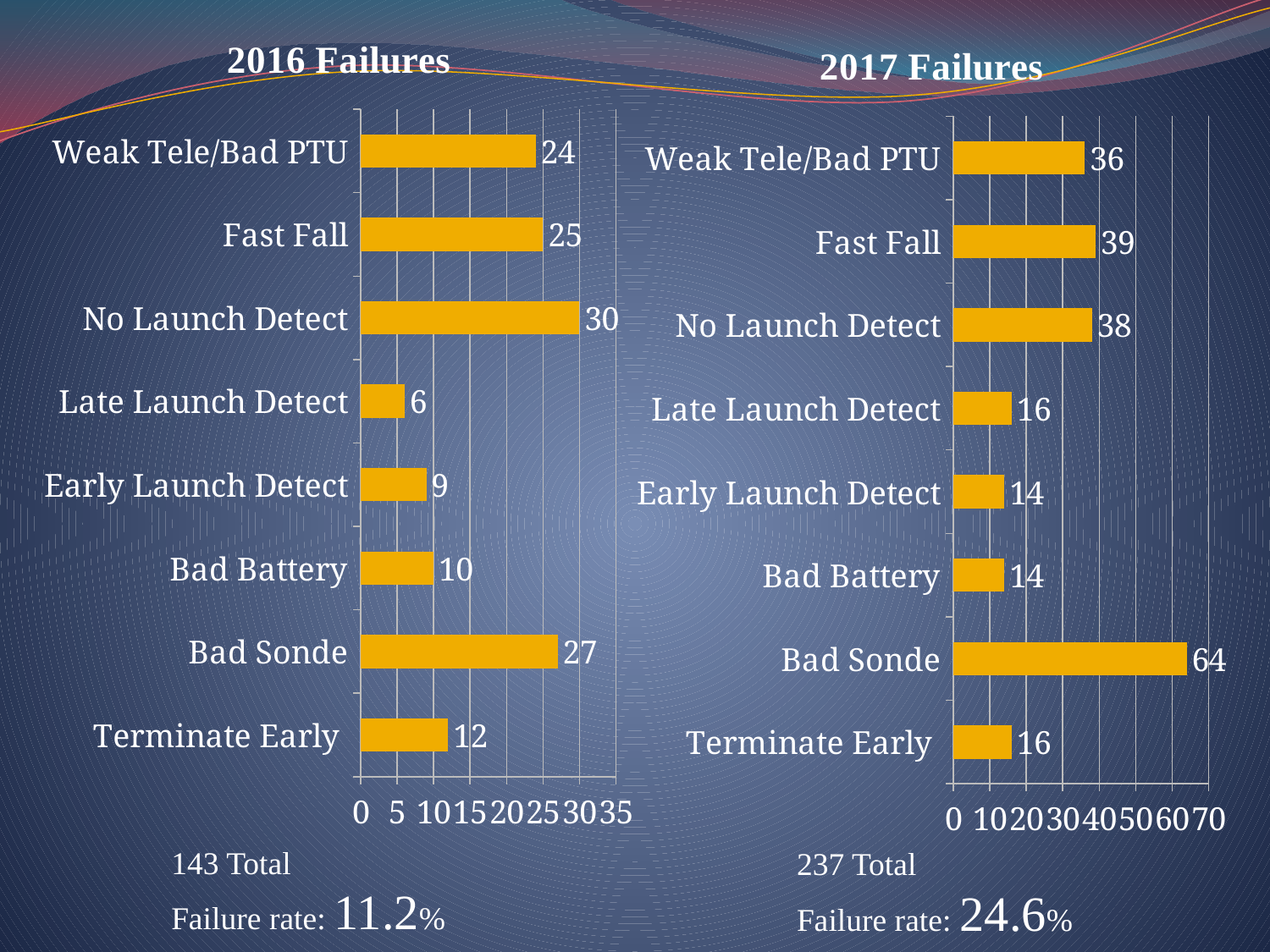
In the 2016 Failures chart, which category has the highest value? No Launch Detect In the 2016 Failures chart, which category has the lowest value? Late Launch Detect In the 2016 Failures chart, what is the difference between Bad Sonde and Terminate Early? 15 In the 2017 Failures chart, which is larger, Weak Tele/Bad PTU or Late Launch Detect? Weak Tele/Bad PTU What kind of chart is the 2016 Failures chart? bar chart In the 2017 Failures chart, what is the value for Bad Sonde? 64 In the 2016 Failures chart, what is the value for No Launch Detect? 30 In the 2016 Failures chart, is the value for Fast Fall greater or less than 20? greater How many categories does the 2017 Failures chart show? 8 In the 2017 Failures chart, what is the value for Early Launch Detect? 14 In the 2017 Failures chart, which category has the highest value? Bad Sonde In the 2017 Failures chart, what is the difference between Bad Sonde and Fast Fall? 25